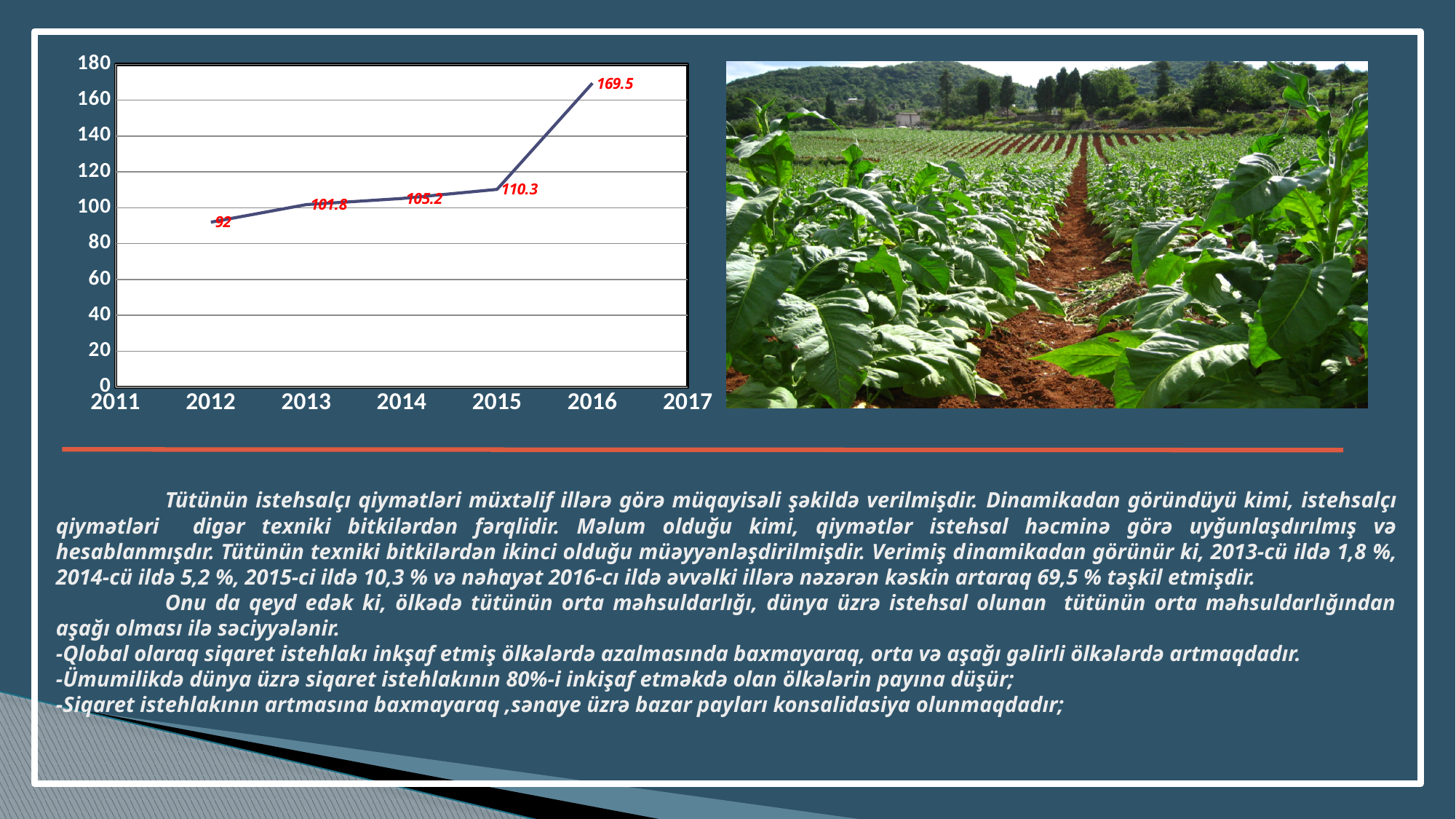
How many data points are plotted on the line? 5 What is the value plotted for 2016? 169.5 Which is larger, the value for 2014 or the value for 2013? 2014 Which year has the highest value on the chart? 2016 What is the difference between the values for 2013 and 2012? 9.8 What is the value plotted for 2015? 110.3 Which year has the lowest value on the chart? 2012 What is the value plotted for 2012? 92 What is the difference between the values for 2016 and 2015? 59.2 What type of chart is shown on the slide? line chart Do the values rise or fall from 2012 to 2016? rise What is the value plotted for 2014? 105.2